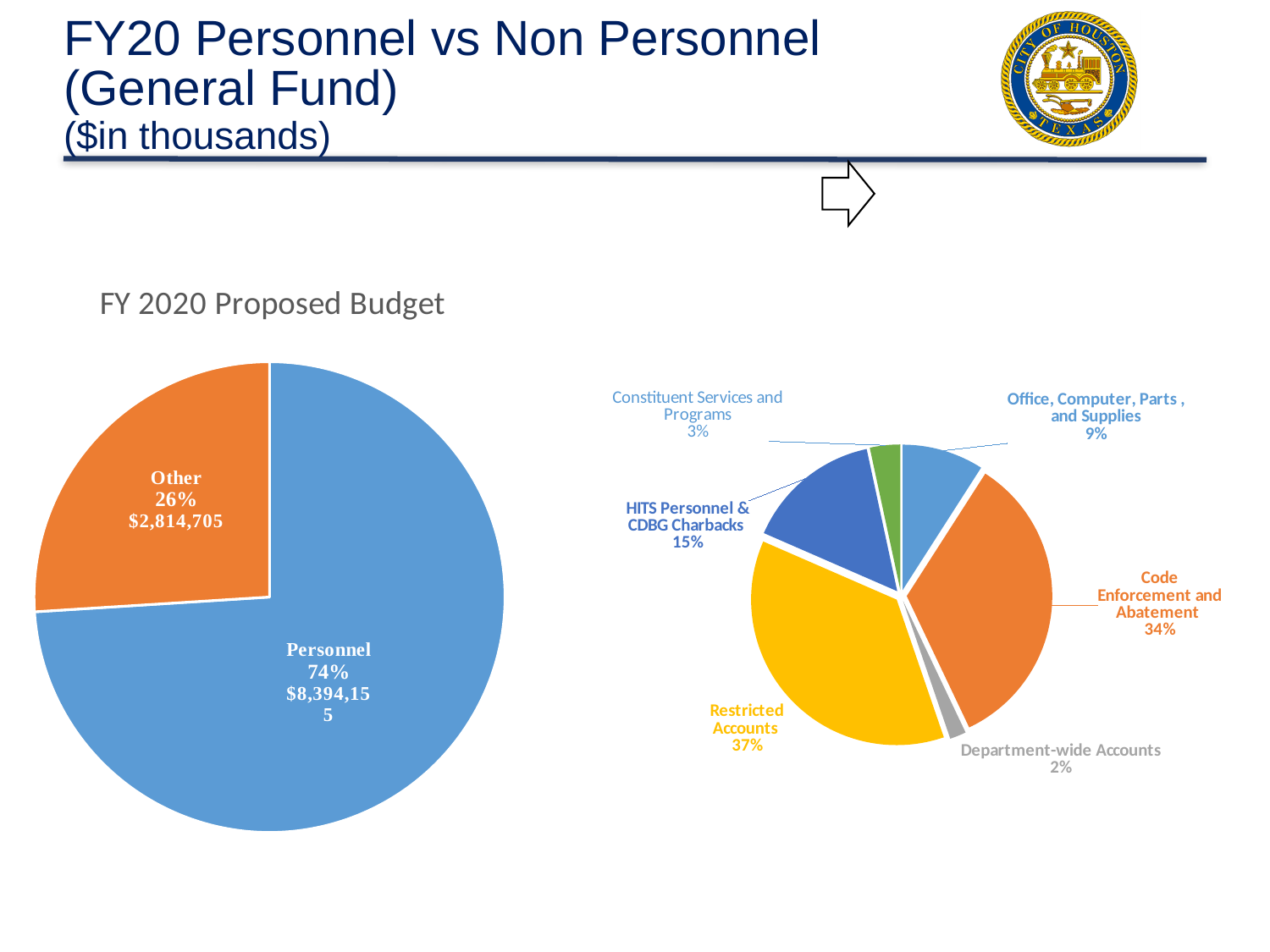
In the pie chart on the right, which category has the largest share? Restricted Accounts In the FY 2020 Proposed Budget pie chart on the left, what is the dollar value shown for Personnel? $8,394,155 In the pie chart on the right, which is larger: Office, Computer, Parts, and Supplies or Constituent Services and Programs? Office, Computer, Parts, and Supplies In the pie chart on the right, what is the difference in percentage points between Restricted Accounts and Code Enforcement and Abatement? 3 percentage points In the pie chart on the right, which category has the smallest share? Department-wide Accounts What kind of chart is the FY 2020 Proposed Budget chart on the left? Pie chart In the FY 2020 Proposed Budget pie chart on the left, what share of the budget is Personnel? 74% In the pie chart on the right, what share is HITS Personnel & CDBG Charbacks? 15% In the FY 2020 Proposed Budget pie chart on the left, how many slices are there? 2 In the FY 2020 Proposed Budget pie chart on the left, what is the dollar value shown for Other? $2,814,705 In the pie chart on the right, how many slices are there? 6 In the pie chart on the right, what share is Code Enforcement and Abatement? 34%